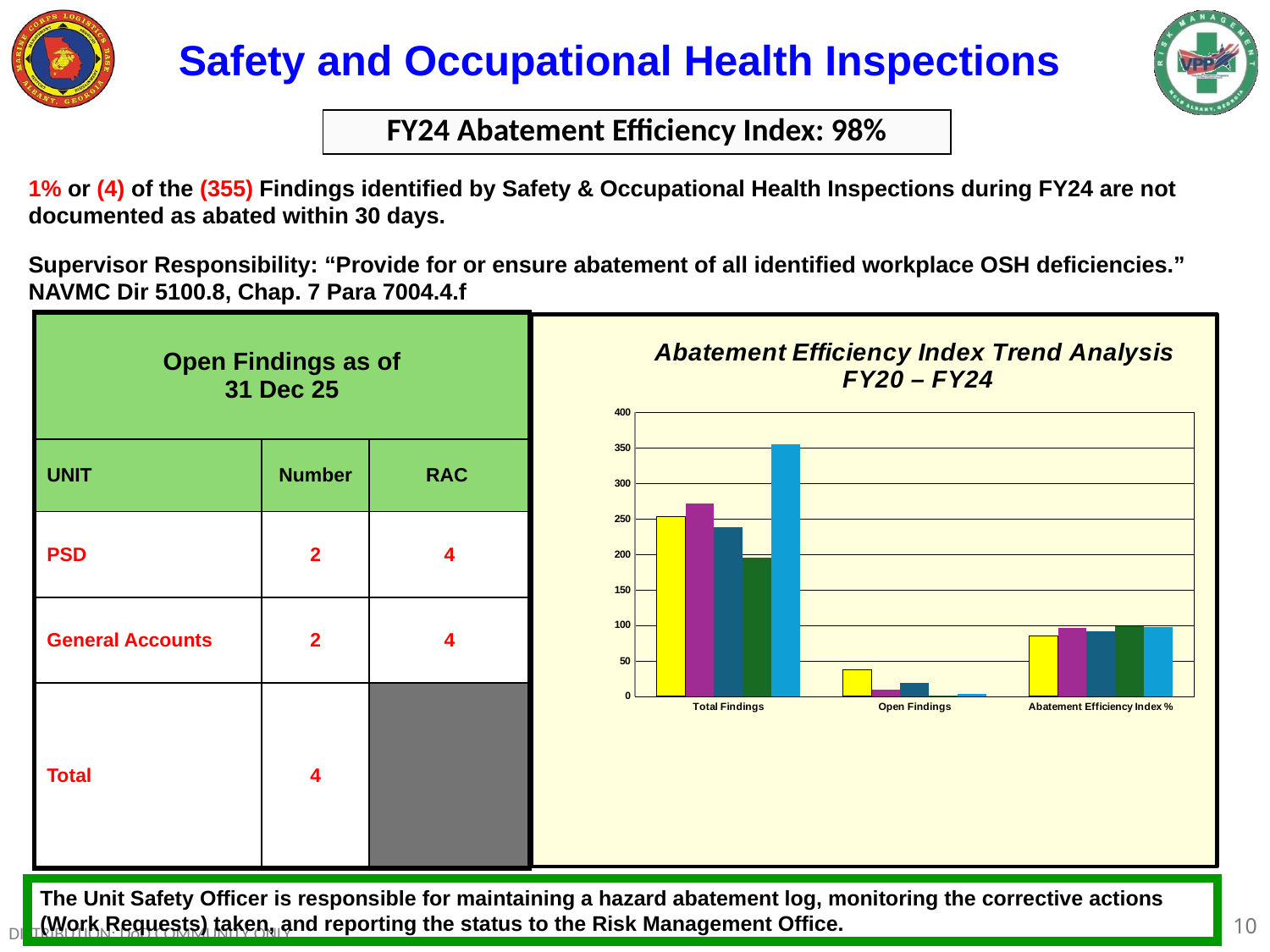
Is the value of the dark green bar for Abatement Efficiency Index % greater or less than 150? less How many categories are shown along the x axis of the chart? 3 Which category on the chart has the shortest bars overall? Open Findings For Total Findings, which bar is taller: the light blue bar or the dark green bar? the light blue bar Is the value of the light blue bar for Total Findings greater or less than 300? greater What is the title of the chart on the slide? Abatement Efficiency Index Trend Analysis FY20 – FY24 What kind of chart is shown on the slide? bar chart For Open Findings, which bar is taller: the yellow bar or the magenta bar? the yellow bar Which category on the chart has the tallest bar overall? Total Findings Is the value of the yellow bar for Total Findings greater or less than 200? greater How many bars are plotted for the Total Findings category? 5